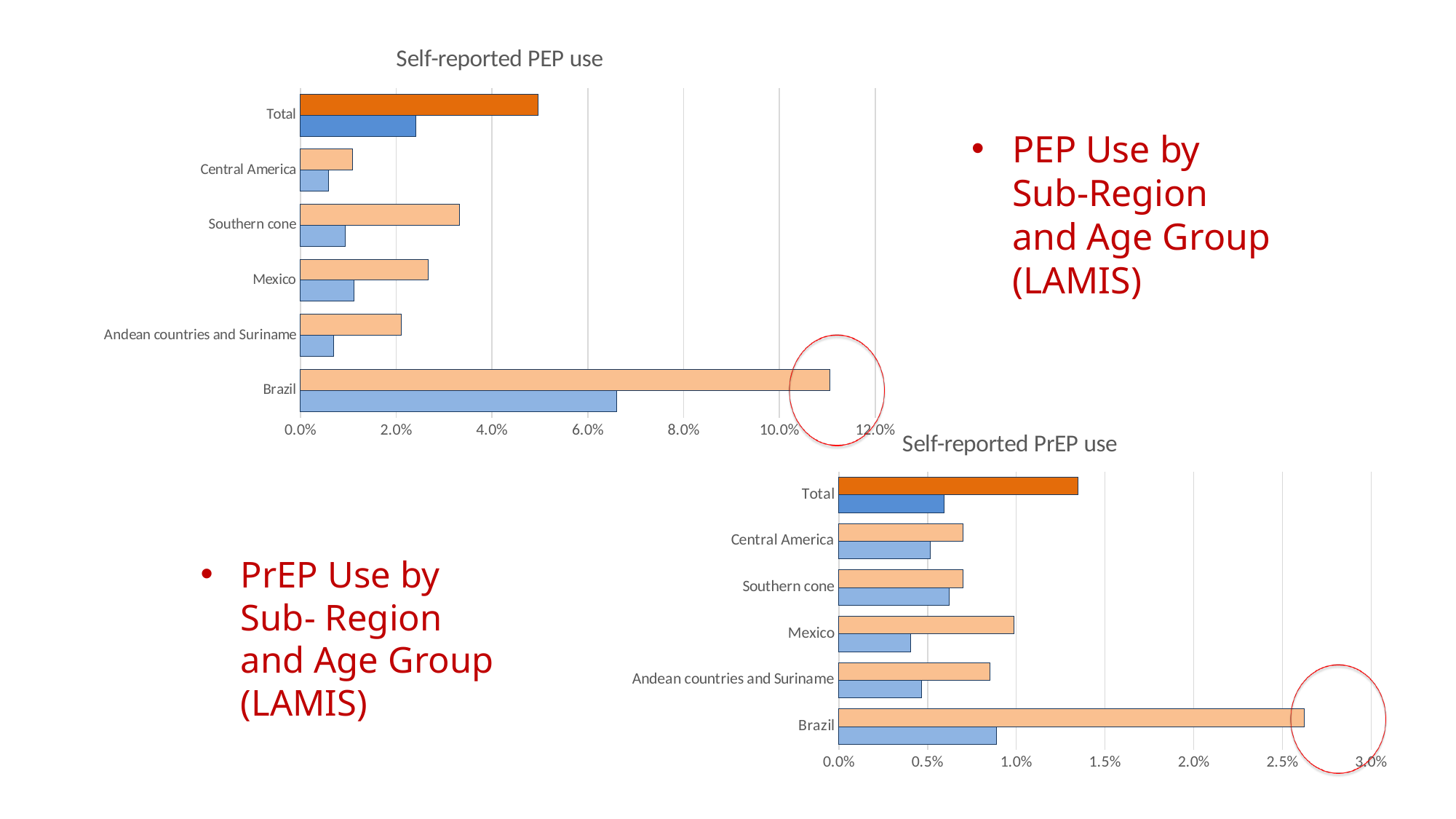
In the 'Self-reported PEP use' chart, which category has the longest orange bar? Brazil In the 'Self-reported PEP use' chart, which has the longer orange bar: Southern cone or Mexico? Southern cone In the 'Self-reported PEP use' chart, which category has the shortest orange bar? Central America In the 'Self-reported PEP use' chart, is the orange bar for Central America greater or less than 2.0%? less In the 'Self-reported PrEP use' chart, which category has the longest orange bar? Brazil In the 'Self-reported PEP use' chart, is the blue bar for Brazil greater or less than 6.0%? greater In the 'Self-reported PEP use' chart, is the orange bar for Brazil greater or less than 10.0%? greater What type of chart is the 'Self-reported PEP use' chart? bar chart What is the title of the chart in the lower right of the slide? Self-reported PrEP use How many categories are shown on the 'Self-reported PrEP use' chart? 6